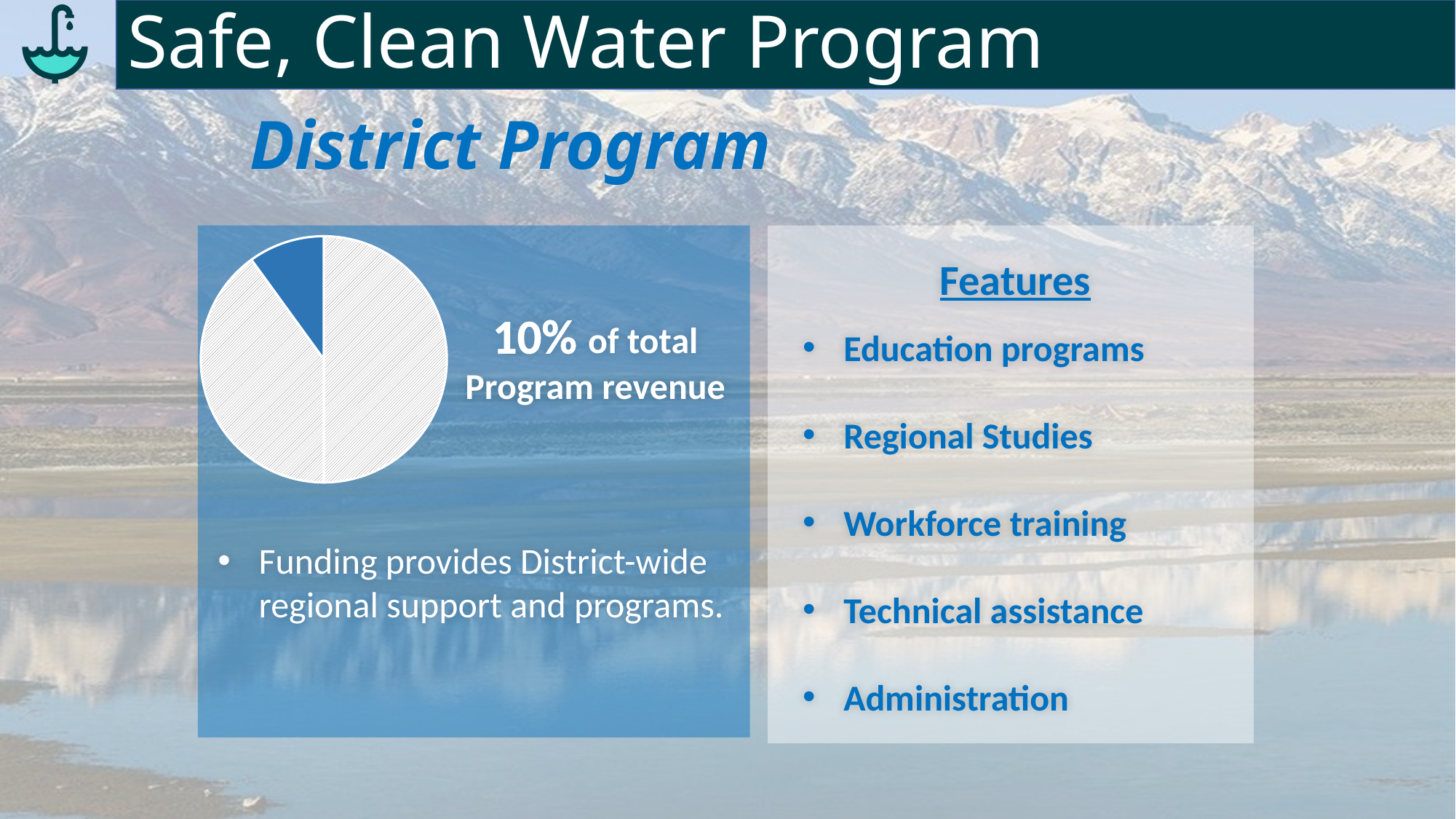
What kind of chart is shown on the slide? Pie chart According to the text next to the pie chart, what does the 10% slice represent? 10% of total Program revenue What colour is the smaller slice of the pie chart? Blue What share of total Program revenue does the solid blue slice of the pie chart represent? 10% Which slice of the pie chart is the smallest? The solid blue slice How many slices does the pie chart have? 3 Which slice of the pie chart is larger, the solid blue slice or the hatched white slice? The hatched white slice